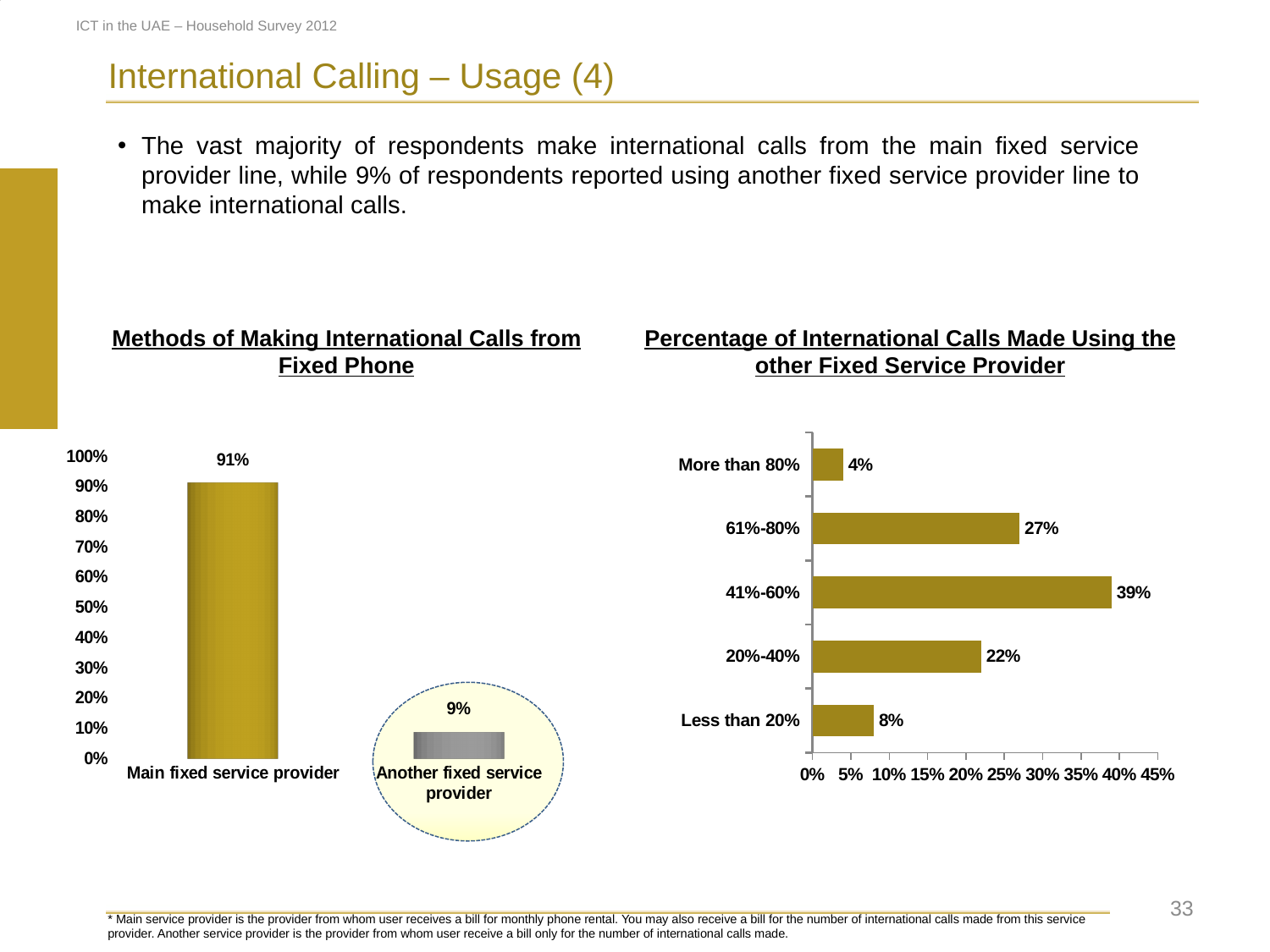
In the 'Percentage of International Calls Made Using the other Fixed Service Provider' chart, which category has the lowest value? More than 80% In the 'Methods of Making International Calls from Fixed Phone' chart, what is the value for Main fixed service provider? 91% What kind of chart is the 'Methods of Making International Calls from Fixed Phone' chart? Bar chart In the 'Percentage of International Calls Made Using the other Fixed Service Provider' chart, what is the value for 41%-60%? 39% In the 'Methods of Making International Calls from Fixed Phone' chart, what is the value for Another fixed service provider? 9% In the 'Percentage of International Calls Made Using the other Fixed Service Provider' chart, what is the value for Less than 20%? 8% In the 'Percentage of International Calls Made Using the other Fixed Service Provider' chart, which is larger: 61%-80% or 20%-40%? 61%-80% In the 'Methods of Making International Calls from Fixed Phone' chart, what is the difference between Main fixed service provider and Another fixed service provider? 82% In the 'Percentage of International Calls Made Using the other Fixed Service Provider' chart, which category has the highest value? 41%-60% In the 'Percentage of International Calls Made Using the other Fixed Service Provider' chart, what is the difference between 61%-80% and 20%-40%? 5% In the 'Percentage of International Calls Made Using the other Fixed Service Provider' chart, how many categories are shown? 5 In the 'Methods of Making International Calls from Fixed Phone' chart, how many categories are shown? 2